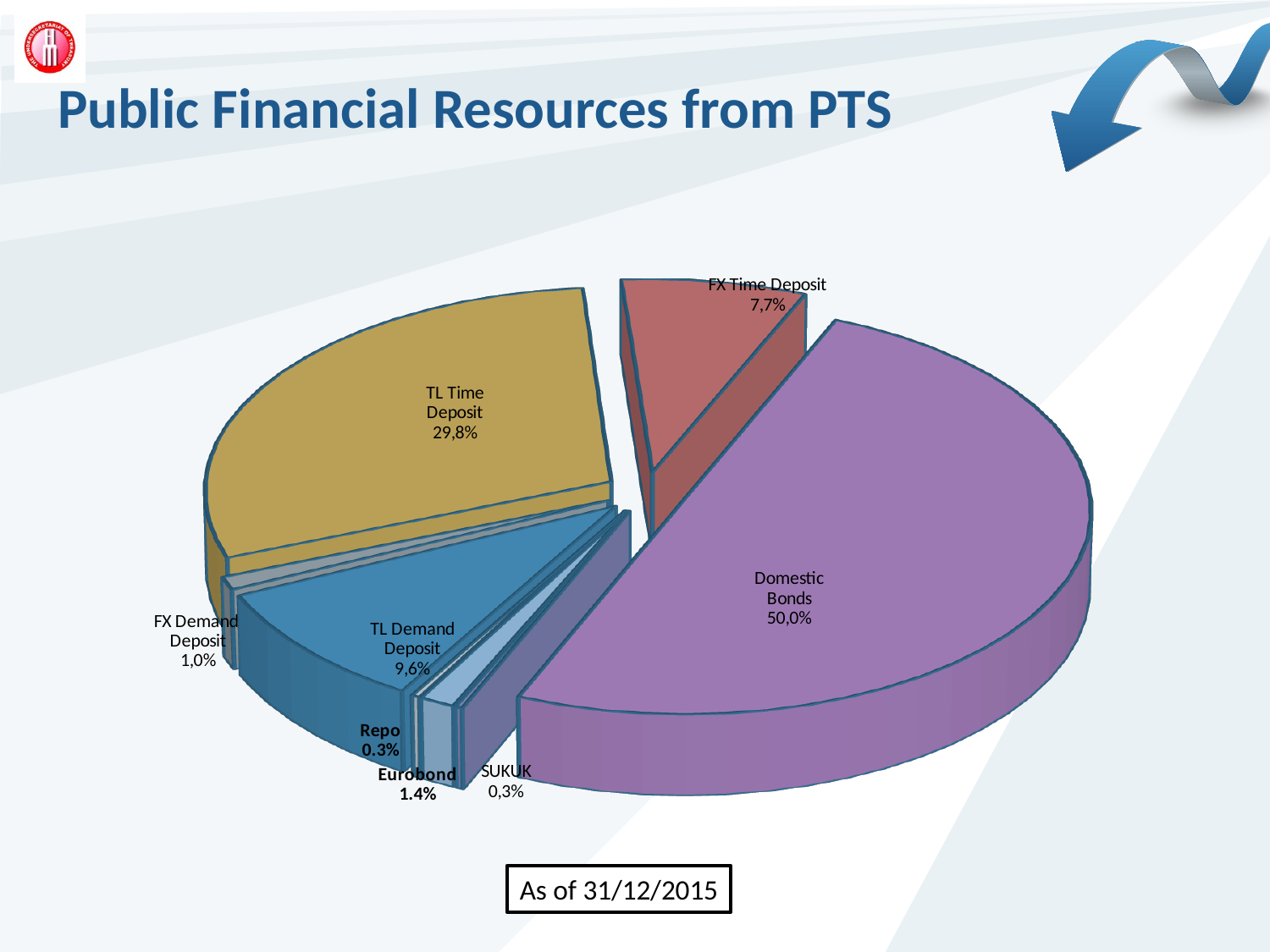
What is the difference in percentage points between Domestic Bonds and TL Time Deposit? 20,2 What is the value shown for FX Time Deposit? 7,7% Which category has the largest slice of the pie? Domestic Bonds What date is the chart data stated to be as of? 31/12/2015 What is the value shown for Eurobond? 1.4% What is the value shown for TL Demand Deposit? 9,6% What is the title of the chart on the slide? Public Financial Resources from PTS Which is larger, TL Time Deposit or FX Time Deposit? TL Time Deposit What is the value shown for TL Time Deposit? 29,8% How many slices does the pie chart have? 8 What kind of chart is shown on the slide? Pie chart What share of the pie does Domestic Bonds hold? 50,0%